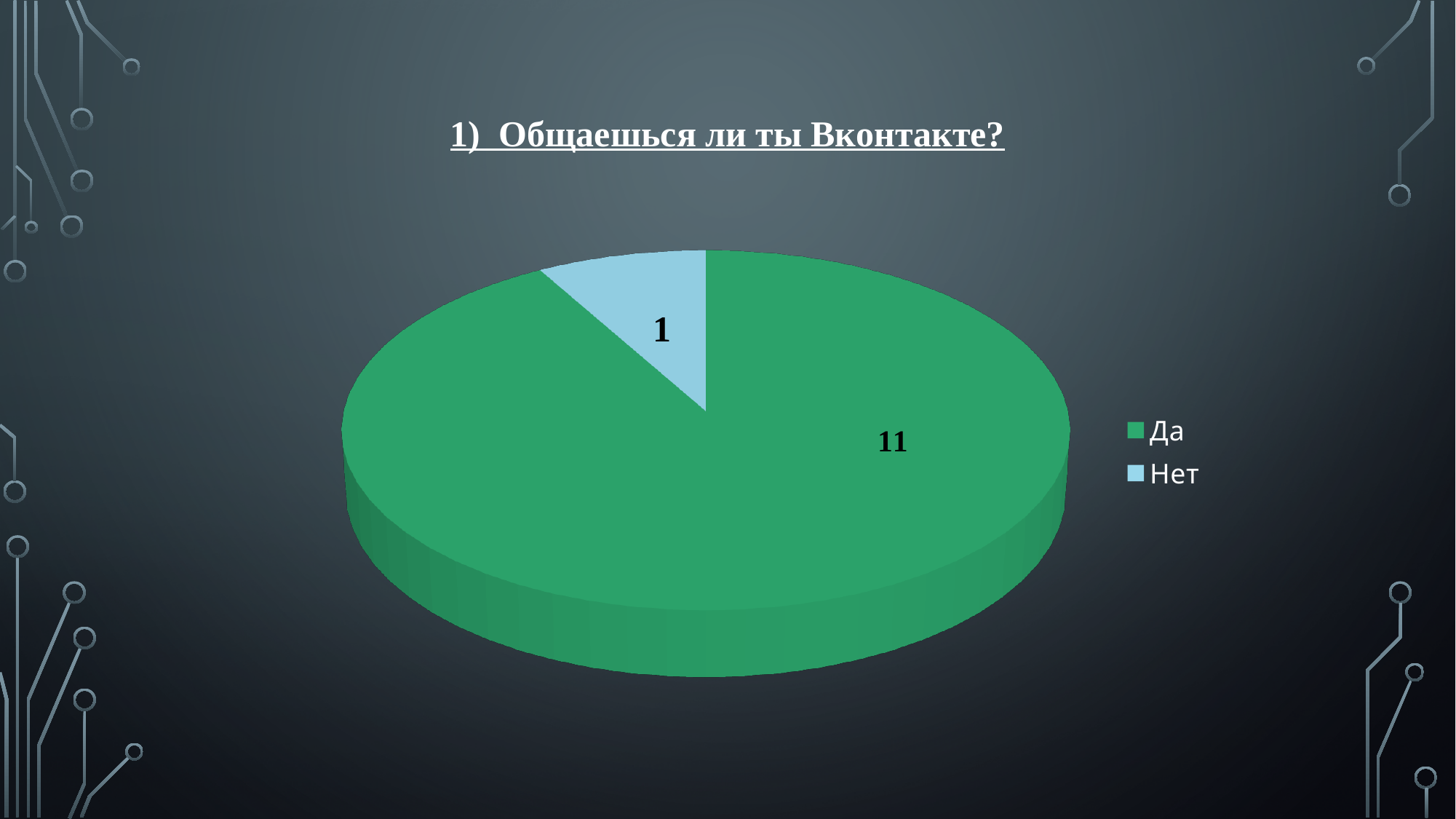
Which category has the smallest slice? Нет What is the value for "Да"? 11 What is the value for "Нет"? 1 Which category has the largest slice? Да How many entries does the legend list? 2 What type of chart is shown on the slide? pie chart Which is larger, the value for "Да" or the value for "Нет"? Да How many categories does the pie chart have? 2 What colour is the slice for "Нет"? light blue What is the difference between the values for "Да" and "Нет"? 10 What is the title of the chart? 1) Общаешься ли ты Вконтакте? What is the total of all slices in the pie chart? 12